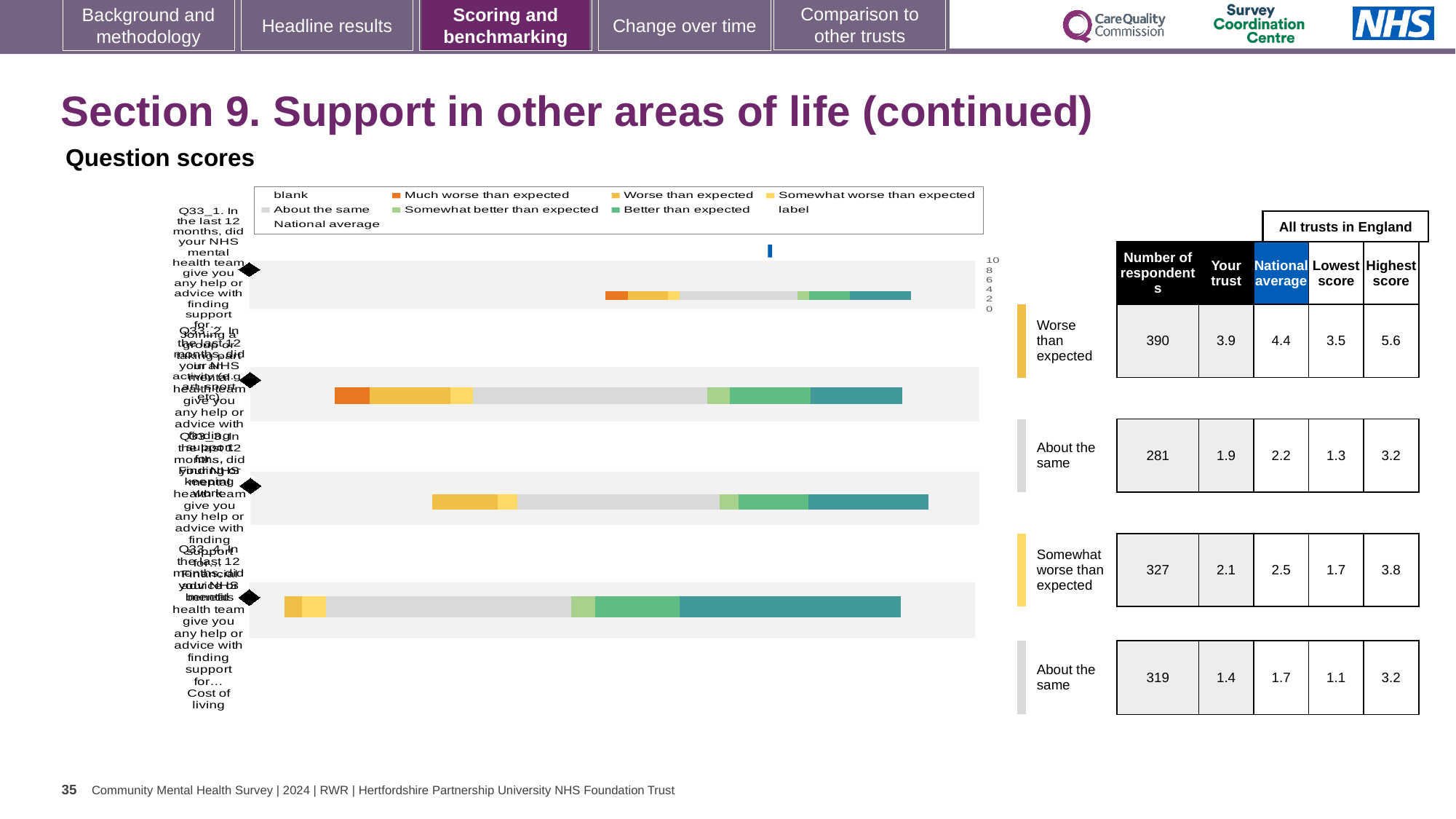
How many entries does the chart legend list? 9 In the table beside the chart, what is the number of respondents for Q33_1? 390 What colour does the legend use for 'Much worse than expected'? orange What colour does the legend use for 'Better than expected'? teal What kind of chart is shown under 'Question scores'? bar chart How many question bars are plotted in the chart? 4 In the table beside the chart, what is the 'Your trust' score for Q33_2? 1.9 In the table beside the chart, what is the highest score for Q33_4? 3.2 For Q33_1, which is larger: the 'Your trust' score or the national average? National average In the table beside the chart, what is the national average for Q33_3? 2.5 Which question has the highest number of respondents in the table? Q33_1 For Q33_1, what is the difference between the national average and the 'Your trust' score? 0.5